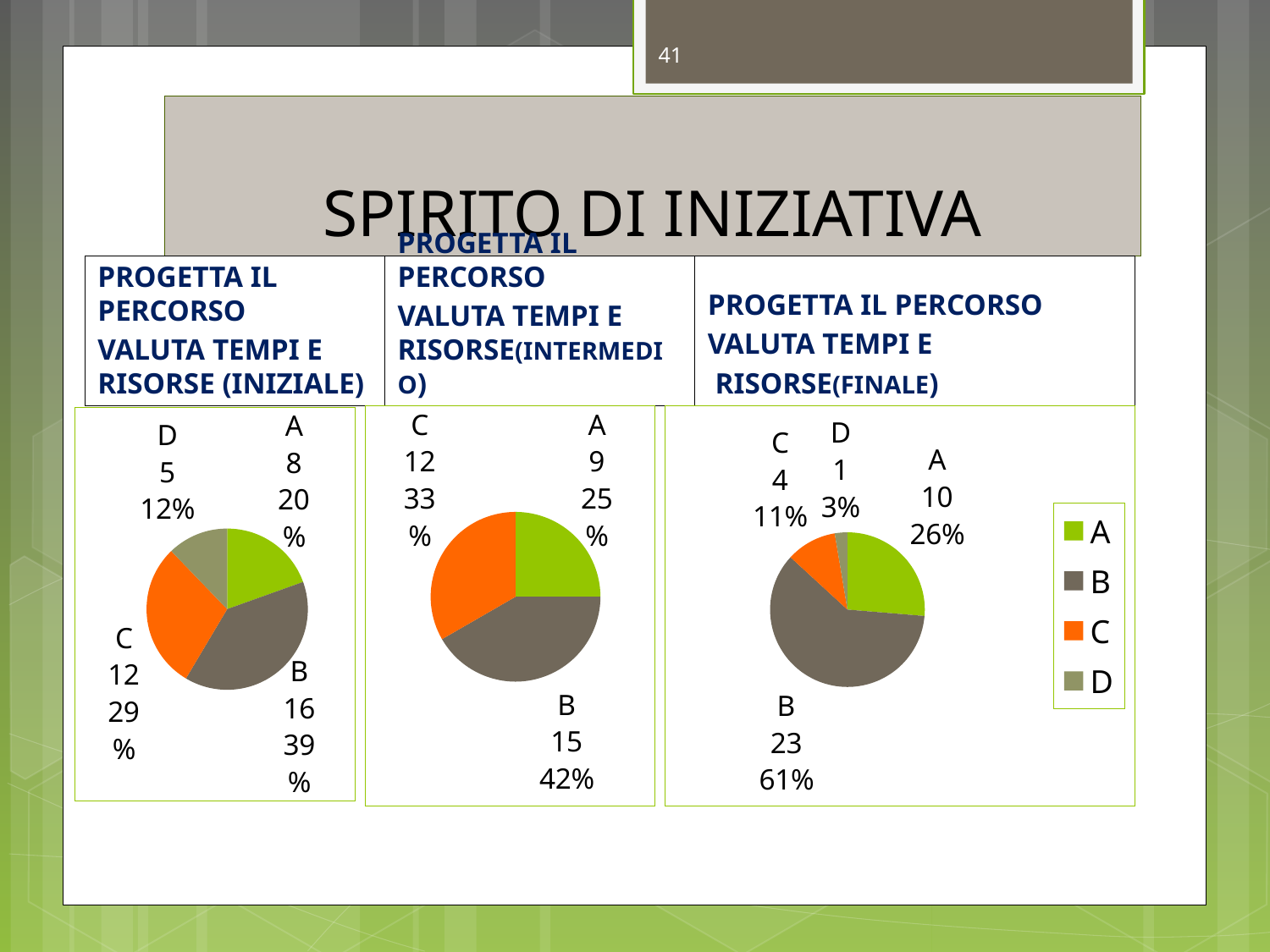
In the middle pie chart (INTERMEDIO), what is the value for C? 12 In the middle pie chart (INTERMEDIO), which category has the largest share? B In the left pie chart (INIZIALE), what is the value for B? 16 What type of chart is used on this slide? Pie chart In the left pie chart (INIZIALE), which category has the smallest value? D How many slices does the middle pie chart (INTERMEDIO) have? 3 In the right pie chart (FINALE), what percentage share does D have? 3% In the right pie chart (FINALE), what is the difference between the values for B and A? 13 In the left pie chart (INIZIALE), what percentage share does C have? 29% How many entries does the legend on the right of the slide list? 4 In the right pie chart (FINALE), what is the value for B? 23 In the right pie chart (FINALE), which is larger, the value for A or the value for C? A